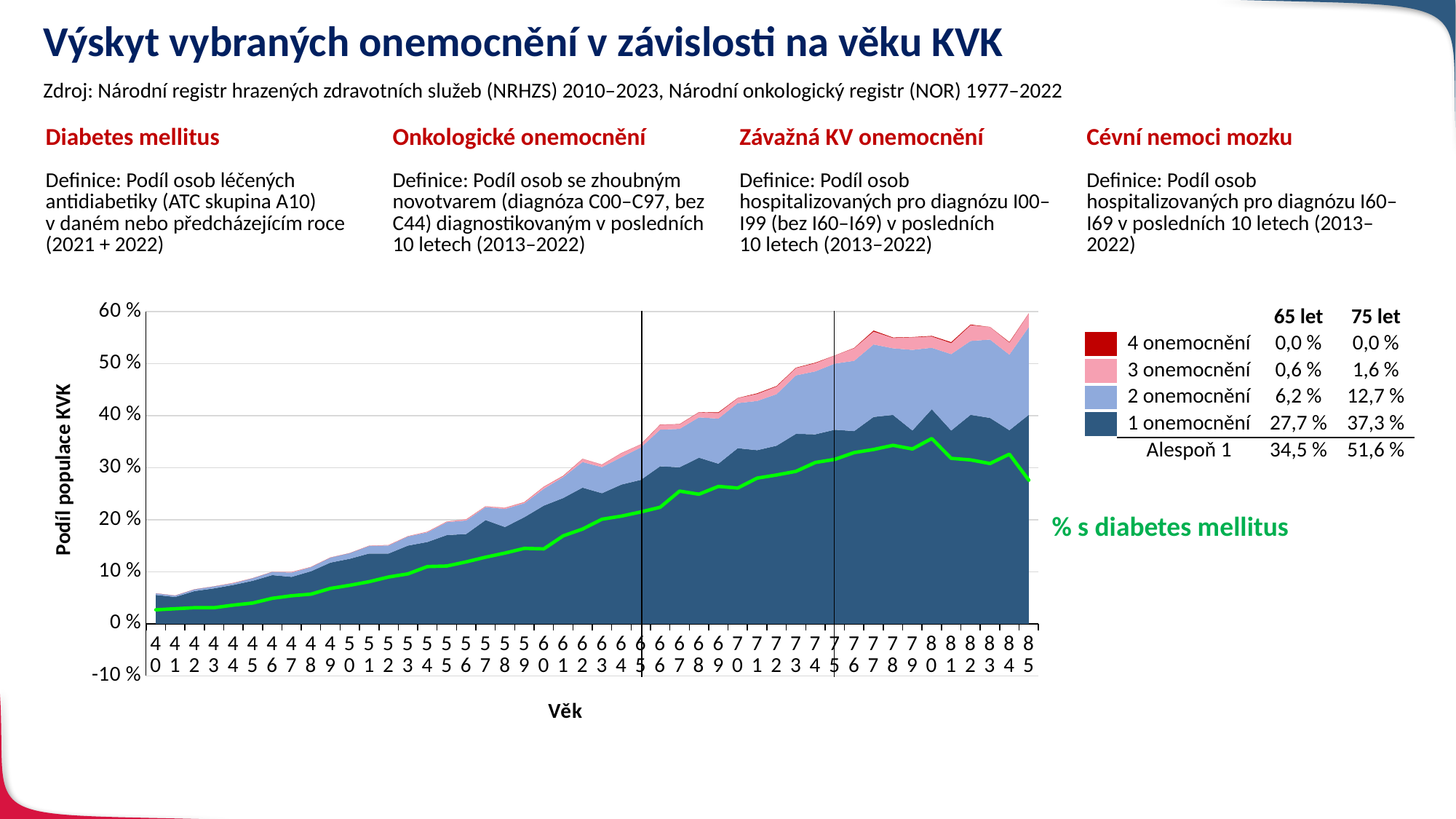
What kind of chart is shown on the slide? combination area and line chart According to the table next to the chart, what share of the population has 2 onemocnění at 75 let? 12,7 % Which category in the table has the lowest value at 75 let? 4 onemocnění What is the label of the vertical axis of the chart? Podíl populace KVK According to the table next to the chart, what is the value for Alespoň 1 at 75 let? 51,6 % Which is larger: the share with 2 onemocnění at 65 let or at 75 let? 75 let According to the table next to the chart, what share of the population has 1 onemocnění at 65 let? 27,7 % Does the share of the population with at least one disease rise or fall as age increases along the x axis? rises By how many percentage points does the Alespoň 1 value at 75 let exceed the value at 65 let? 17,1 How many age categories are shown on the x axis of the chart? 46 Is the value of the green line (% s diabetes mellitus) at age 40 greater or less than 10 %? less According to the table next to the chart, what is the value for 3 onemocnění at 65 let? 0,6 %